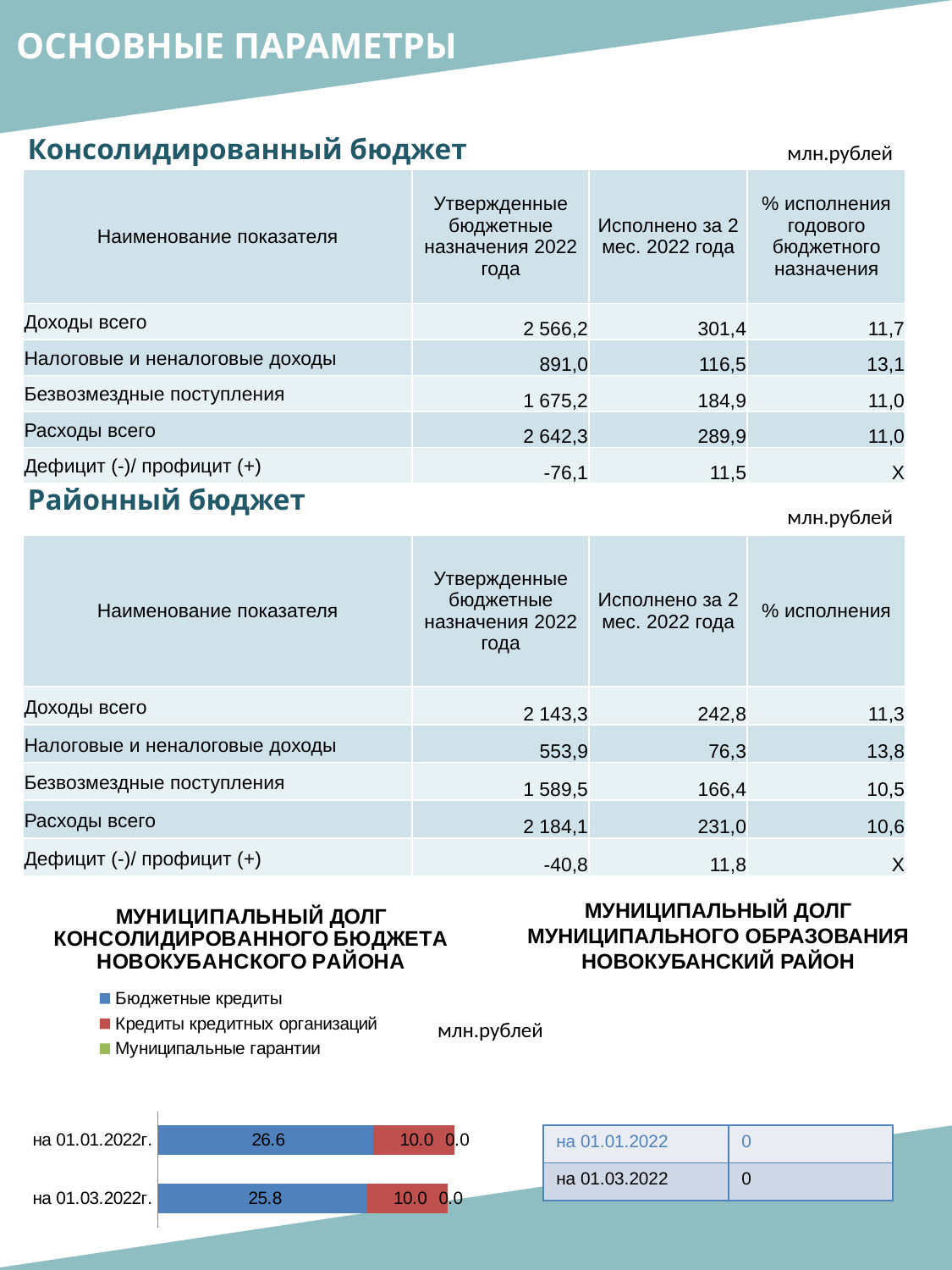
In the municipal debt chart, what is the total debt on 01.01.2022 (sum of all stacked segments)? 36.6 In the municipal debt chart, what is the value of Бюджетные кредиты on 01.03.2022? 25.8 How many series does the legend of the municipal debt chart list? 3 In the municipal debt chart, which date has the larger value for Бюджетные кредиты, 01.01.2022 or 01.03.2022? 01.01.2022 What type of chart is shown at the bottom left of the slide? bar chart In the municipal debt chart, what is the total debt on 01.03.2022 (sum of all stacked segments)? 35.8 In the municipal debt chart, which colour represents Кредиты кредитных организаций? red In the municipal debt chart, by how much did Бюджетные кредиты change from 01.01.2022 to 01.03.2022? 0.8 In the municipal debt chart, what is the value of Кредиты кредитных организаций on 01.03.2022? 10.0 In the municipal debt chart, what is the value of Муниципальные гарантии on 01.01.2022? 0.0 In the municipal debt chart, what is the value of Бюджетные кредиты on 01.01.2022? 26.6 How many categories (dates) are plotted in the municipal debt chart? 2